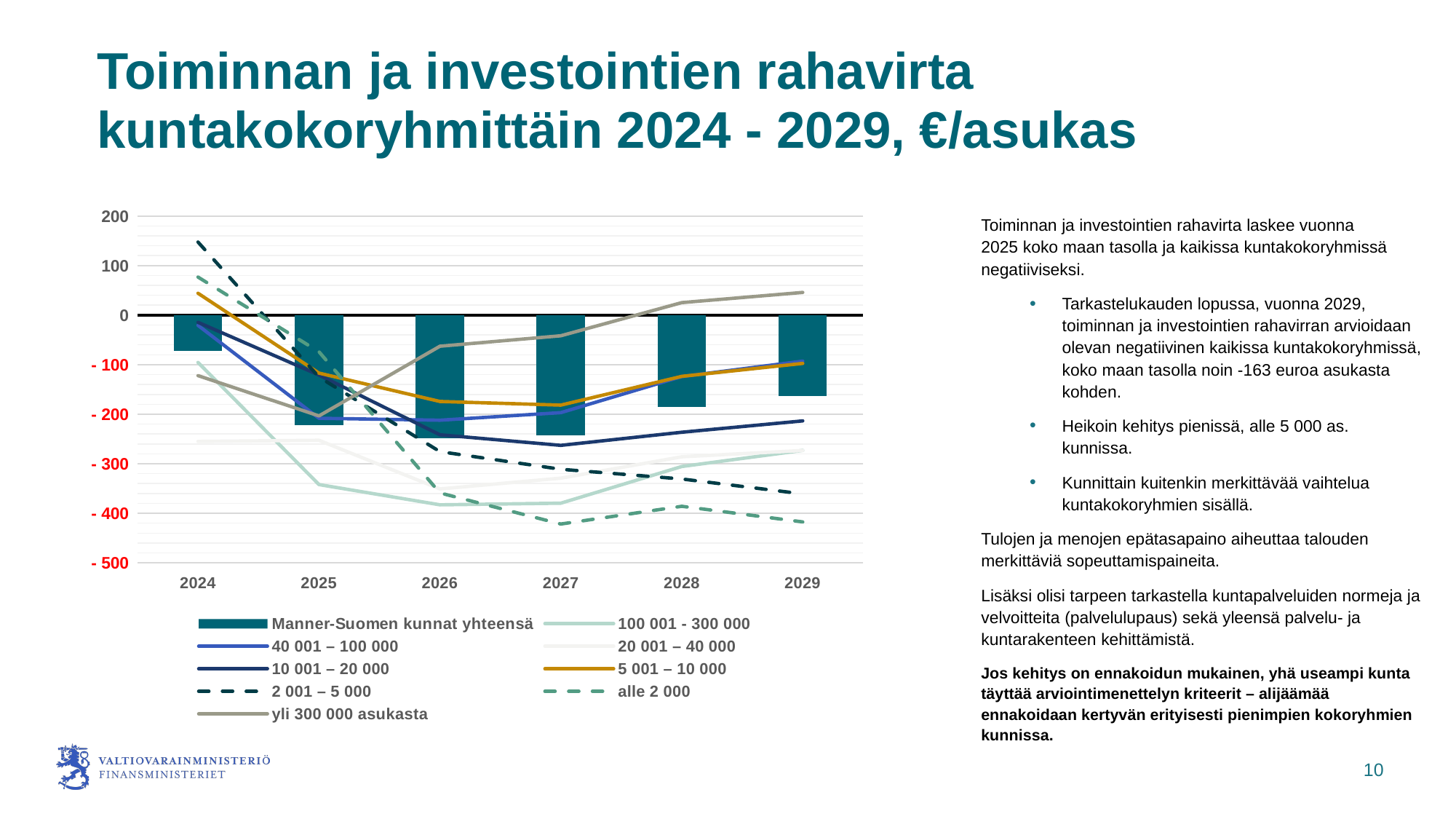
Is the value for yli 300 000 asukasta in 2029 greater or less than 0? greater Which series has the highest value in 2029? yli 300 000 asukasta Is the value for 2 001 – 5 000 in 2024 greater or less than 100? greater In which year is the bar for Manner-Suomen kunnat yhteensä highest? 2024 How many series does the chart legend list? 9 Is the value for alle 2 000 in 2027 greater or less than -300? less How many years are shown on the x axis of the chart? 6 What kind of chart is shown on the slide? A combination bar and line chart Does the 2 001 – 5 000 series rise or fall from 2024 to 2029? fall Which series is plotted as bars in the chart? Manner-Suomen kunnat yhteensä